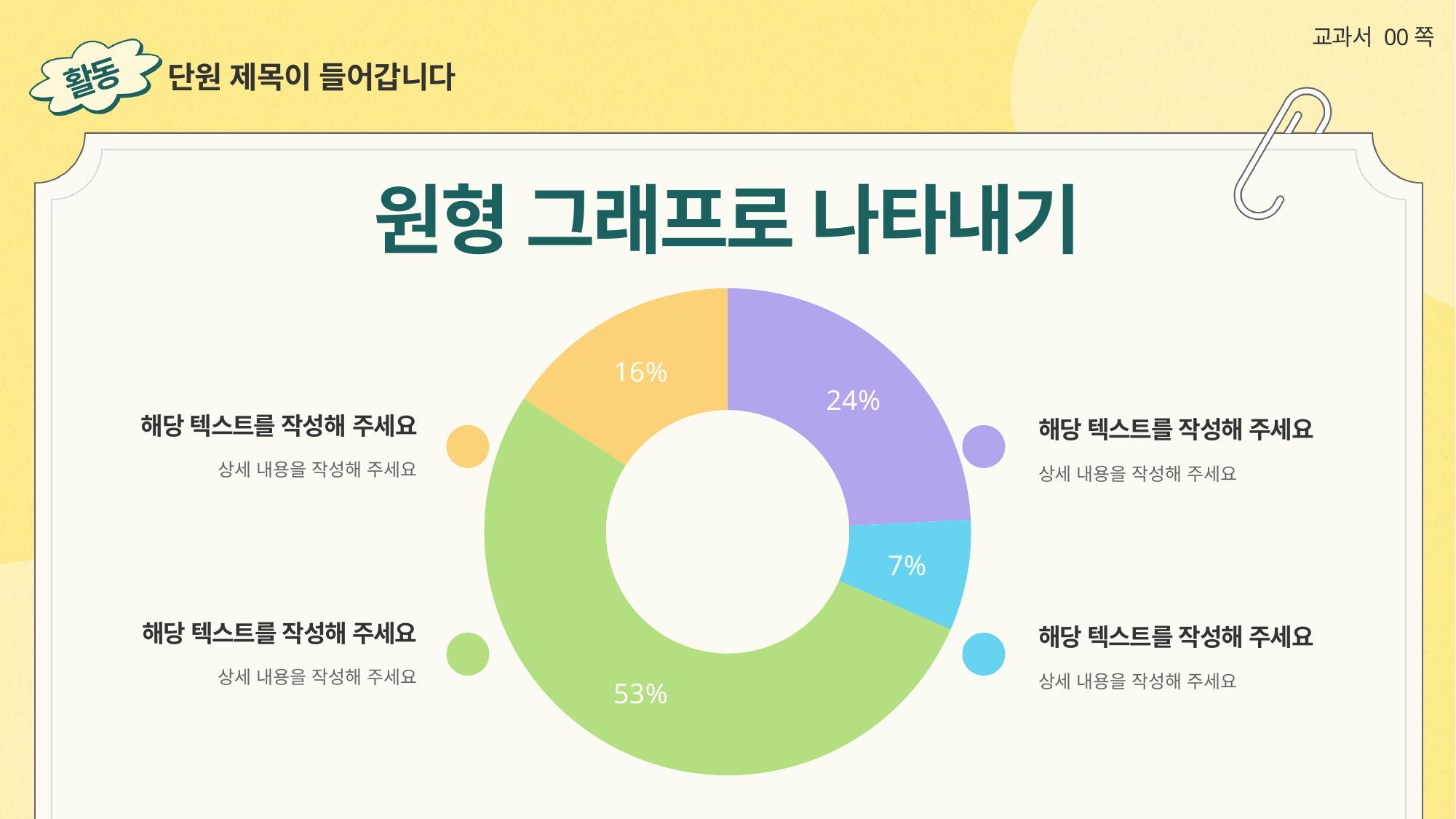
How many slices does the pie chart have? 4 What is the combined share of the purple and blue slices in the pie chart? 31% What percentage is shown on the green slice of the pie chart? 53% What is the difference between the purple slice and the orange slice in the pie chart? 8% What is the title written above the pie chart? 원형 그래프로 나타내기 Which slice of the pie chart is the smallest? The blue slice (7%) What percentage is shown on the blue slice of the pie chart? 7% Which is larger in the pie chart, the orange slice or the blue slice? The orange slice What percentage is shown on the orange slice of the pie chart? 16% What percentage is shown on the purple slice of the pie chart? 24% What kind of chart is shown on the slide? Pie chart (donut) Which slice of the pie chart is the largest? The green slice (53%)